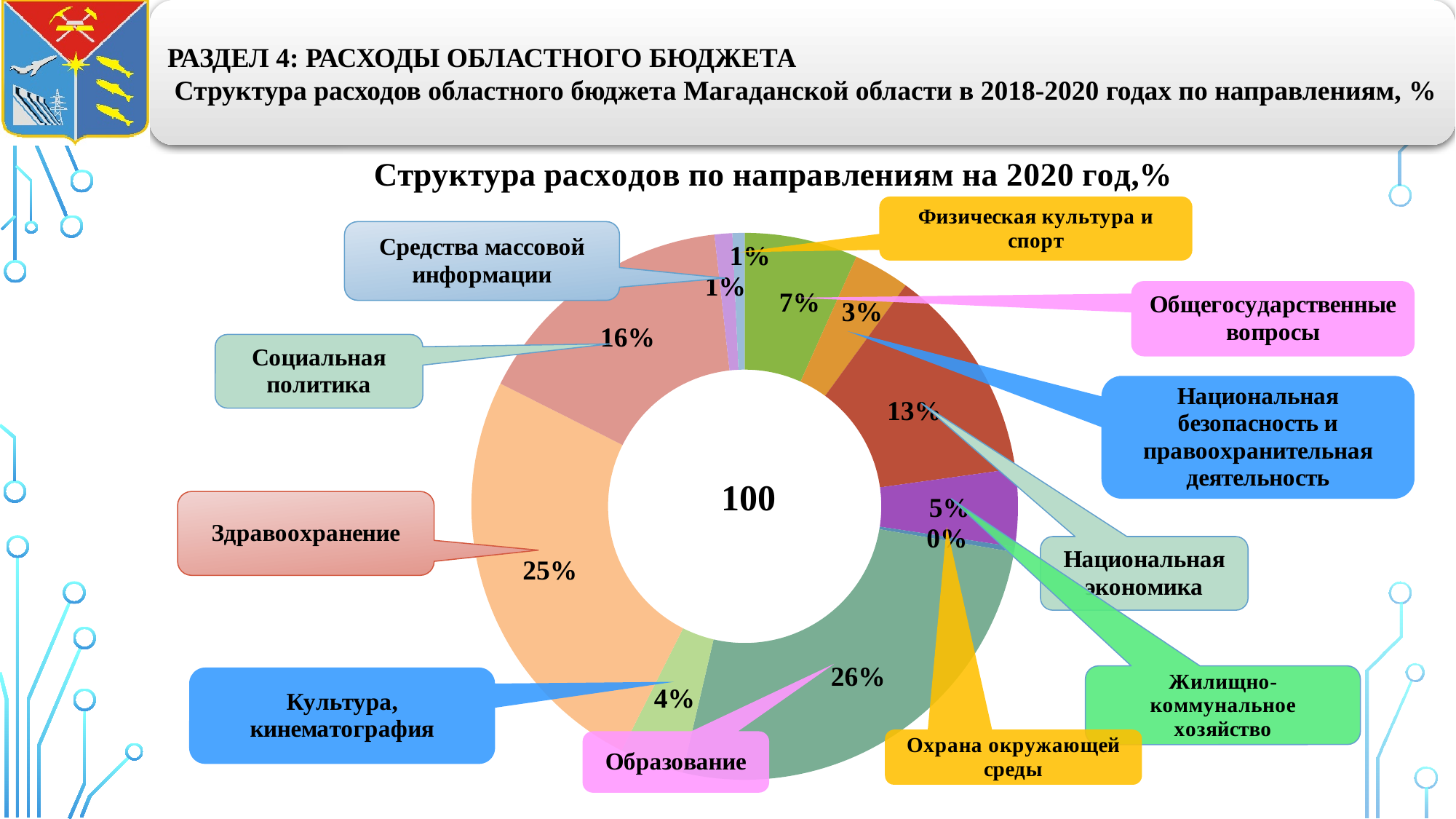
Which category has the largest share of expenditures? Образование What share of expenditures goes to Социальная политика? 16% What is the title of the chart on the slide? Структура расходов по направлениям на 2020 год,% Which category has the smallest share of expenditures? Охрана окружающей среды What share of expenditures goes to Образование? 26% What number is printed in the centre of the doughnut chart? 100 What share of expenditures goes to Здравоохранение? 25% Which has a larger share, Здравоохранение or Социальная политика? Здравоохранение What is the difference in percentage points between Образование and Здравоохранение? 1 What share of expenditures goes to Культура, кинематография? 4% What kind of chart is shown on the slide? Pie (doughnut) chart What share of expenditures goes to Охрана окружающей среды? 0%